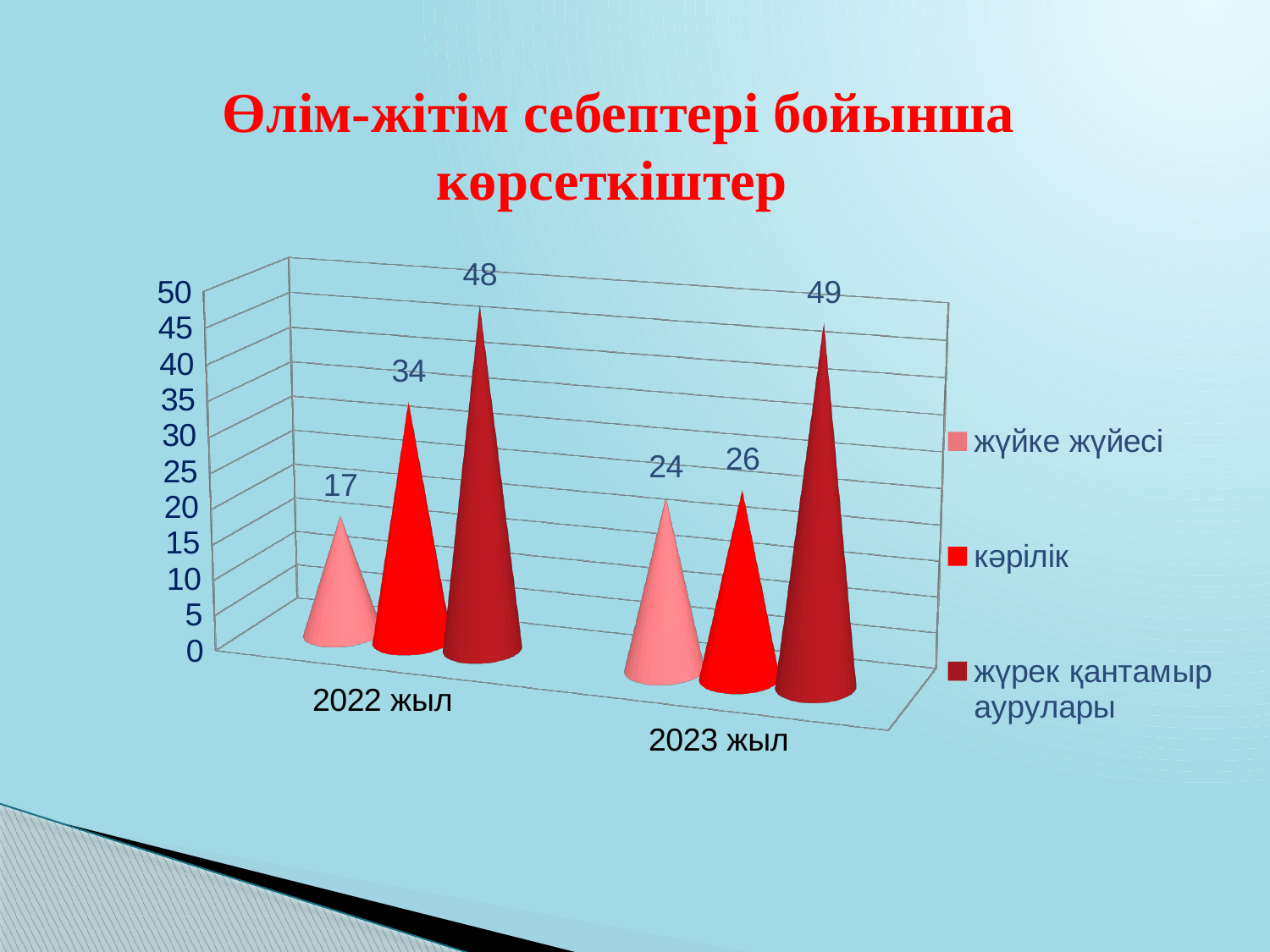
What is the value for жүрек қантамыр аурулары in 2022 жыл? 48 How many categories are shown on the x axis? 2 What is the title of the chart on the slide? Өлім-жітім себептері бойынша көрсеткіштер Does the value for жүрек қантамыр аурулары rise or fall from 2022 жыл to 2023 жыл? rise What kind of chart is shown on the slide? bar chart What is the value for жүйке жүйесі in 2022 жыл? 17 Which is larger: жүйке жүйесі in 2022 жыл or жүйке жүйесі in 2023 жыл? 2023 жыл Which series has the lowest value in 2022 жыл? жүйке жүйесі Which series has the highest value in 2023 жыл? жүрек қантамыр аурулары How many series does the legend list? 3 What is the value for кәрілік in 2023 жыл? 26 What is the difference between the кәрілік values for 2022 жыл and 2023 жыл? 8